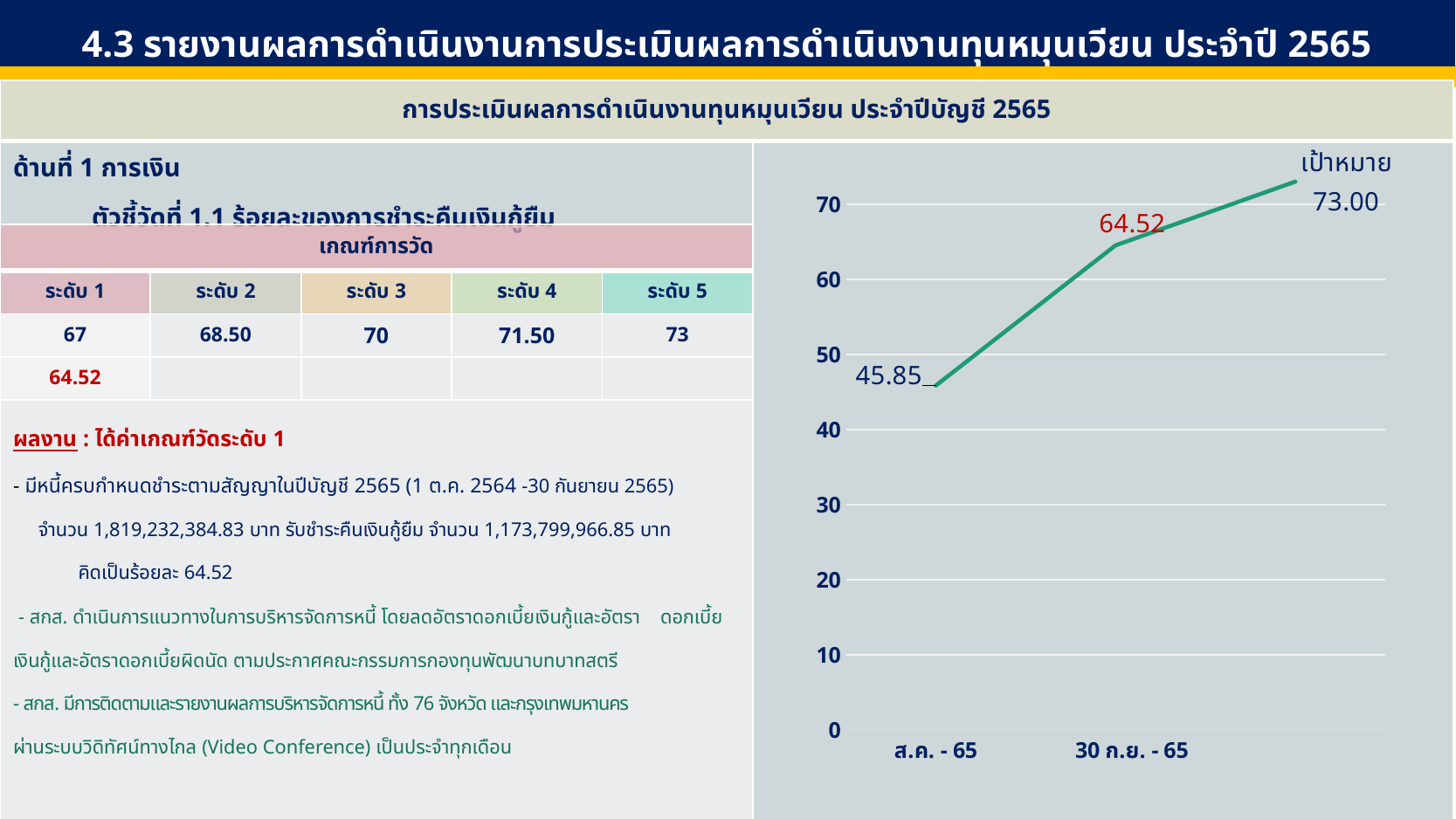
Does the line in the chart rise or fall from ส.ค. - 65 to เป้าหมาย? rise Which point in the line chart has the lowest value? ส.ค. - 65 What is the value plotted for 30 ก.ย. - 65 in the line chart? 64.52 What is the value plotted for ส.ค. - 65 in the line chart? 45.85 What is the highest tick value shown on the vertical axis of the line chart? 70 What is the difference between the เป้าหมาย value and the value for 30 ก.ย. - 65 in the line chart? 8.48 What type of chart is shown on the right side of the slide? line chart What is the value labelled เป้าหมาย in the line chart? 73.00 In the line chart, which is larger: the value for ส.ค. - 65 or the value for 30 ก.ย. - 65? 30 ก.ย. - 65 Which point in the line chart has the highest value? เป้าหมาย Is the value for ส.ค. - 65 in the line chart greater or less than 50? less What is the difference between the value for 30 ก.ย. - 65 and the value for ส.ค. - 65 in the line chart? 18.67